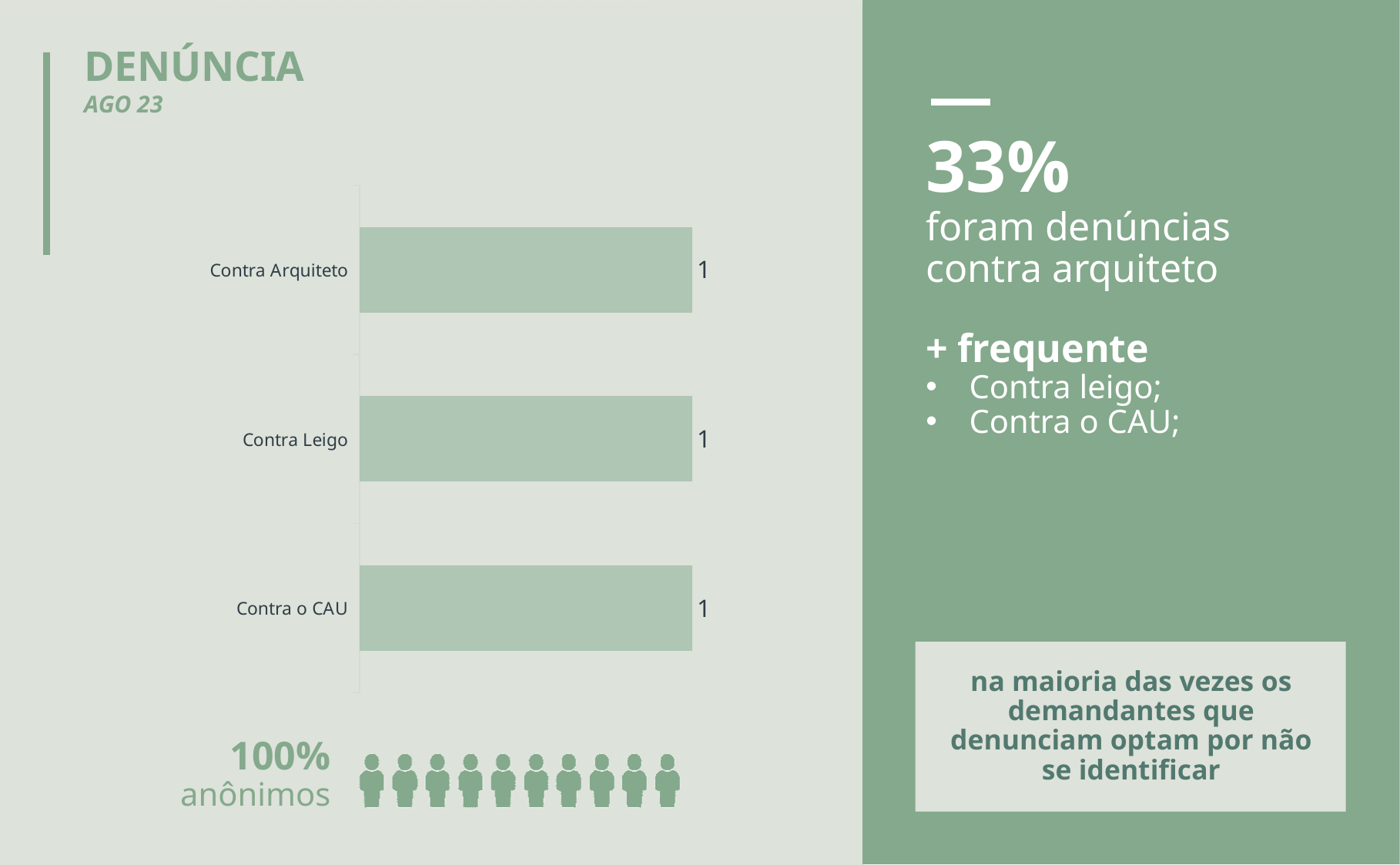
Which category is listed at the top of the bar chart? Contra Arquiteto What is the value for Contra o CAU in the bar chart? 1 What is the sum of the values of all three bars in the chart? 3 What is the difference between the values for Contra Leigo and Contra o CAU? 0 What is the value for Contra Leigo in the bar chart? 1 What is the difference between the values for Contra Arquiteto and Contra Leigo? 0 How many categories are shown in the bar chart? 3 What kind of chart is shown on the slide? Bar chart Do all three bars in the chart have the same value? Yes What is the value for Contra Arquiteto in the bar chart? 1 What is the title shown above the chart on the slide? DENÚNCIA